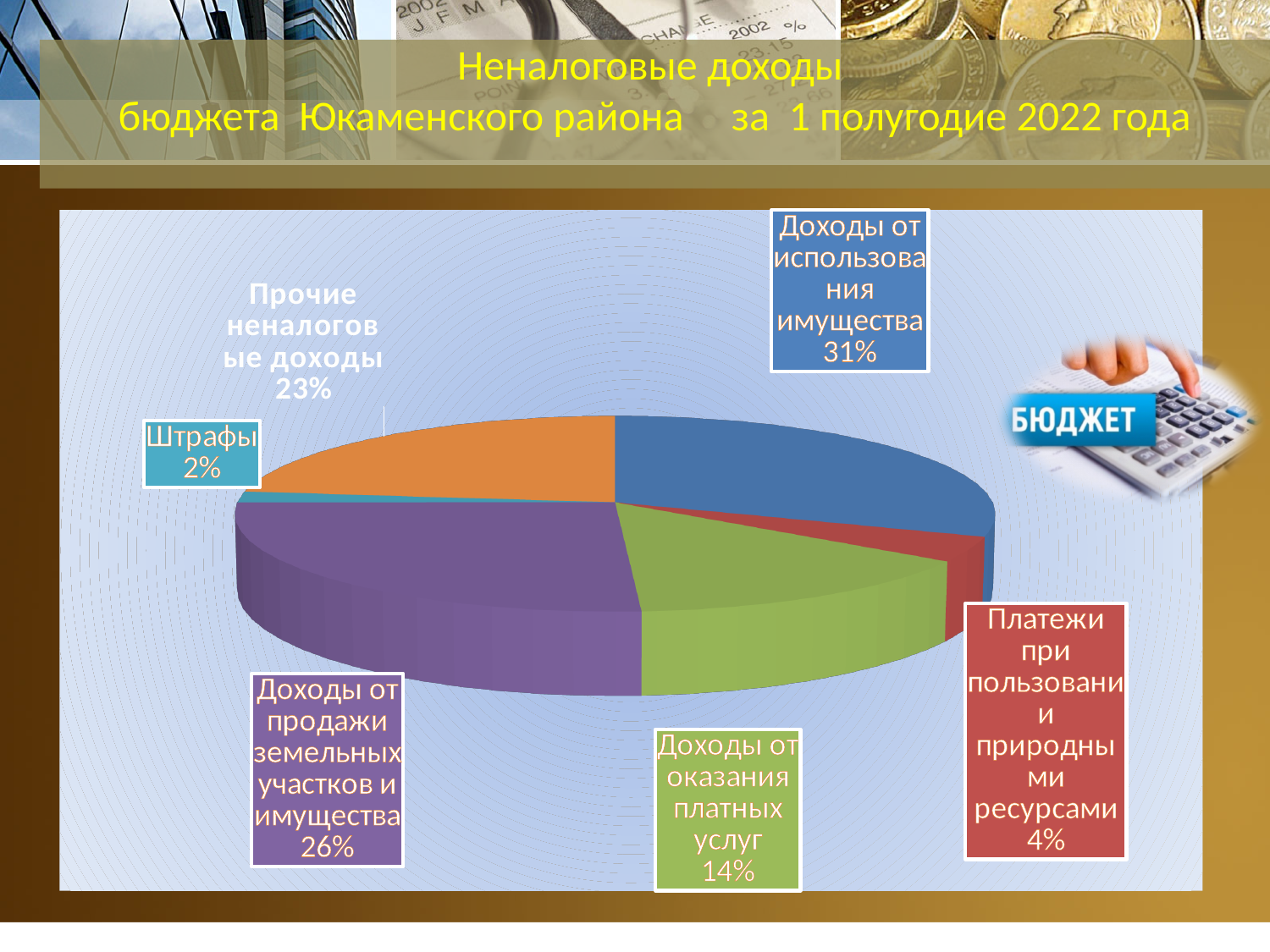
What share is shown for Доходы от оказания платных услуг? 14% What period does the chart title say the data covers? 1 полугодие 2022 года Which category has the largest share of the pie? Доходы от использования имущества What share of non-tax revenues comes from Доходы от использования имущества? 31% Which is larger: Прочие неналоговые доходы or Доходы от оказания платных услуг? Прочие неналоговые доходы What share is shown for Прочие неналоговые доходы? 23% What share is shown for Штрафы? 2% What kind of chart is shown on the slide? pie chart What share is shown for Платежи при пользовании природными ресурсами? 4% What is the difference in percentage points between Доходы от использования имущества and Доходы от продажи земельных участков и имущества? 5 How many categories are shown in the pie chart? 6 Which category has the smallest share of the pie? Штрафы